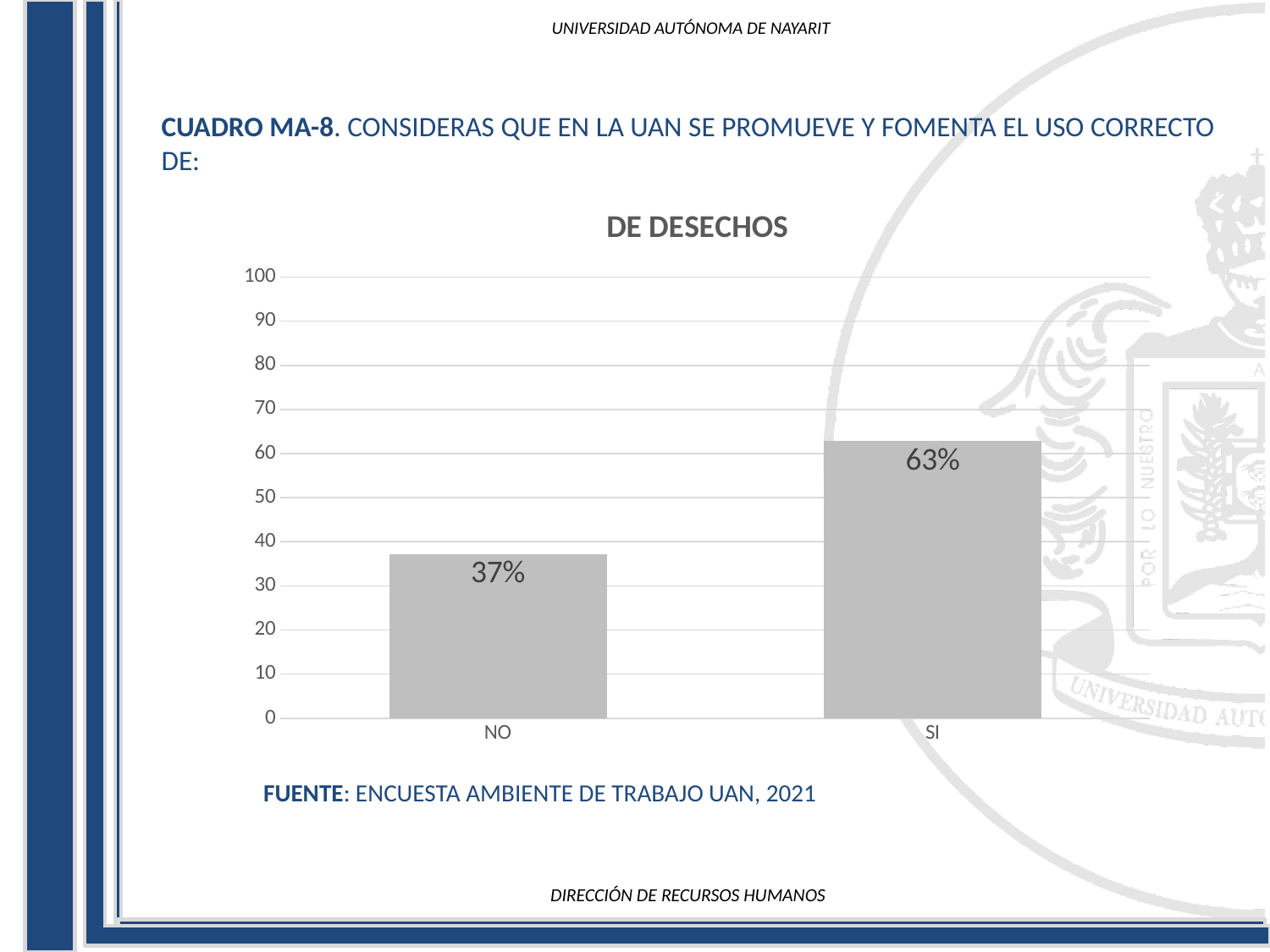
Which is larger, the value for NO or the value for SI? SI Which category has the highest value? SI What is the maximum value shown on the y axis? 100 What is the value for SI? 63% Is the value for SI greater or less than 50? greater Is the value for NO greater or less than 40? less Which category has the lowest value? NO What is the difference between the values for SI and NO? 26% What is the value for NO? 37% How many categories are shown on the x axis? 2 What is the title of the chart? DE DESECHOS What kind of chart is shown on the slide? bar chart